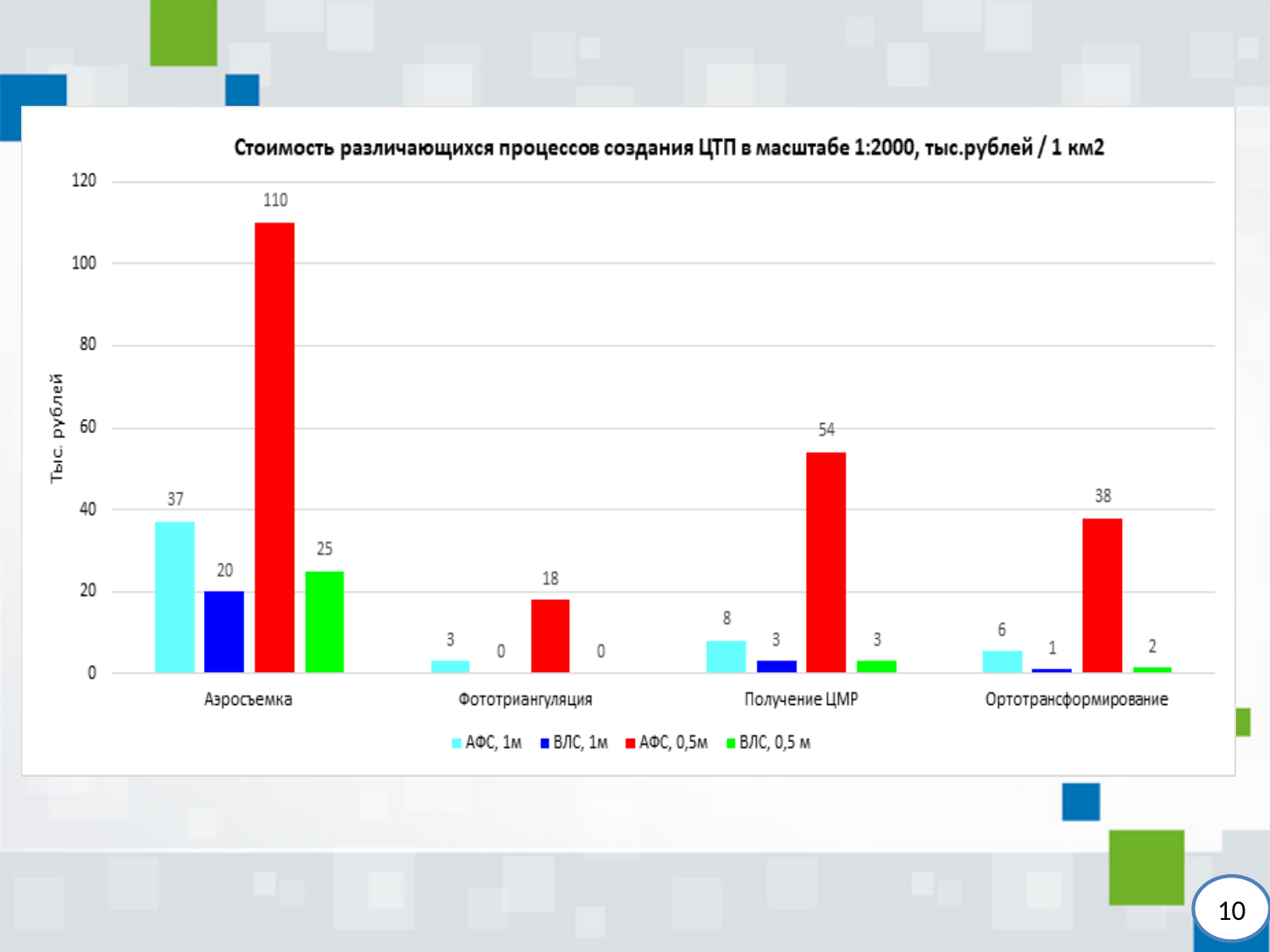
What is the label of the vertical axis? Тыс. рублей Which category has the lowest value for the АФС, 1м series? Фототриангуляция How many series does the legend list? 4 Which is larger in the Получение ЦМР category: АФС, 0,5м or ВЛС, 0,5 м? АФС, 0,5м What kind of chart is shown on the slide? Bar chart What is the value for АФС, 1м in the Получение ЦМР category? 8 How many categories are shown on the x axis? 4 What is the difference between the АФС, 0,5м and АФС, 1м values in the Аэросъемка category? 73 Which category has the highest value for the АФС, 0,5м series? Аэросъемка What is the value for ВЛС, 1м in the Аэросъемка category? 20 What is the value for ВЛС, 0,5 м in the Ортотрансформирование category? 2 What is the value for АФС, 0,5м in the Аэросъемка category? 110